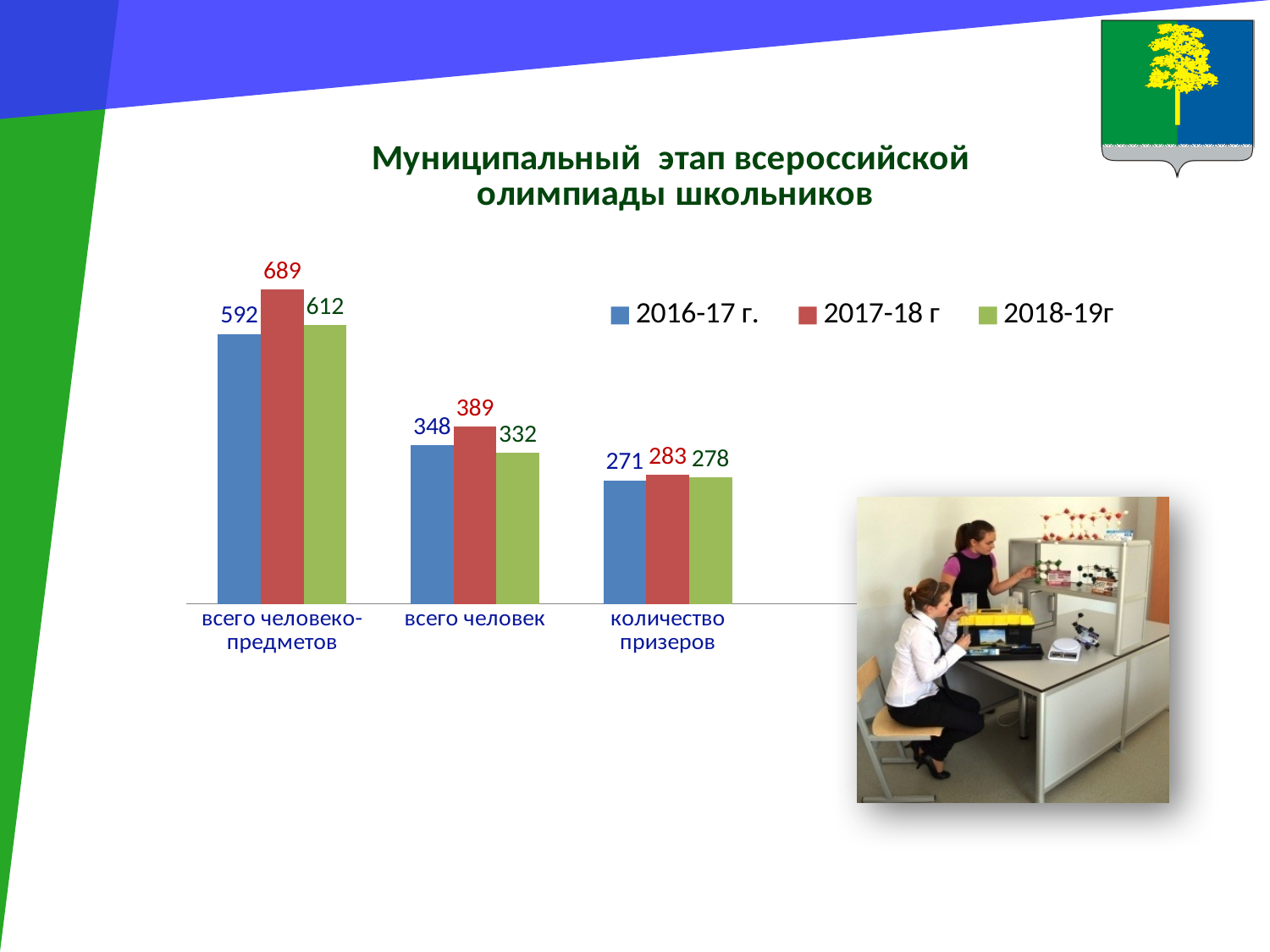
What is the value for 2017-18 г in the category 'всего человеко-предметов'? 689 What is the value for 2018-19г in the category 'количество призеров'? 278 How many series does the legend list? 3 Which colour represents the 2017-18 г series in the chart? red What kind of chart is shown on the slide? bar chart How many categories are shown on the x axis of the chart? 3 Which series has the highest value in the category 'всего человеко-предметов'? 2017-18 г Which series has the lowest value in the category 'всего человек'? 2018-19г Which is larger: the 2016-17 г. value or the 2018-19г value in the category 'всего человеко-предметов'? 2018-19г What is the difference between the 2017-18 г and 2018-19г values in the category 'всего человек'? 57 What is the value for 2016-17 г. in the category 'всего человек'? 348 What is the difference between the 2017-18 г and 2016-17 г. values in the category 'всего человеко-предметов'? 97